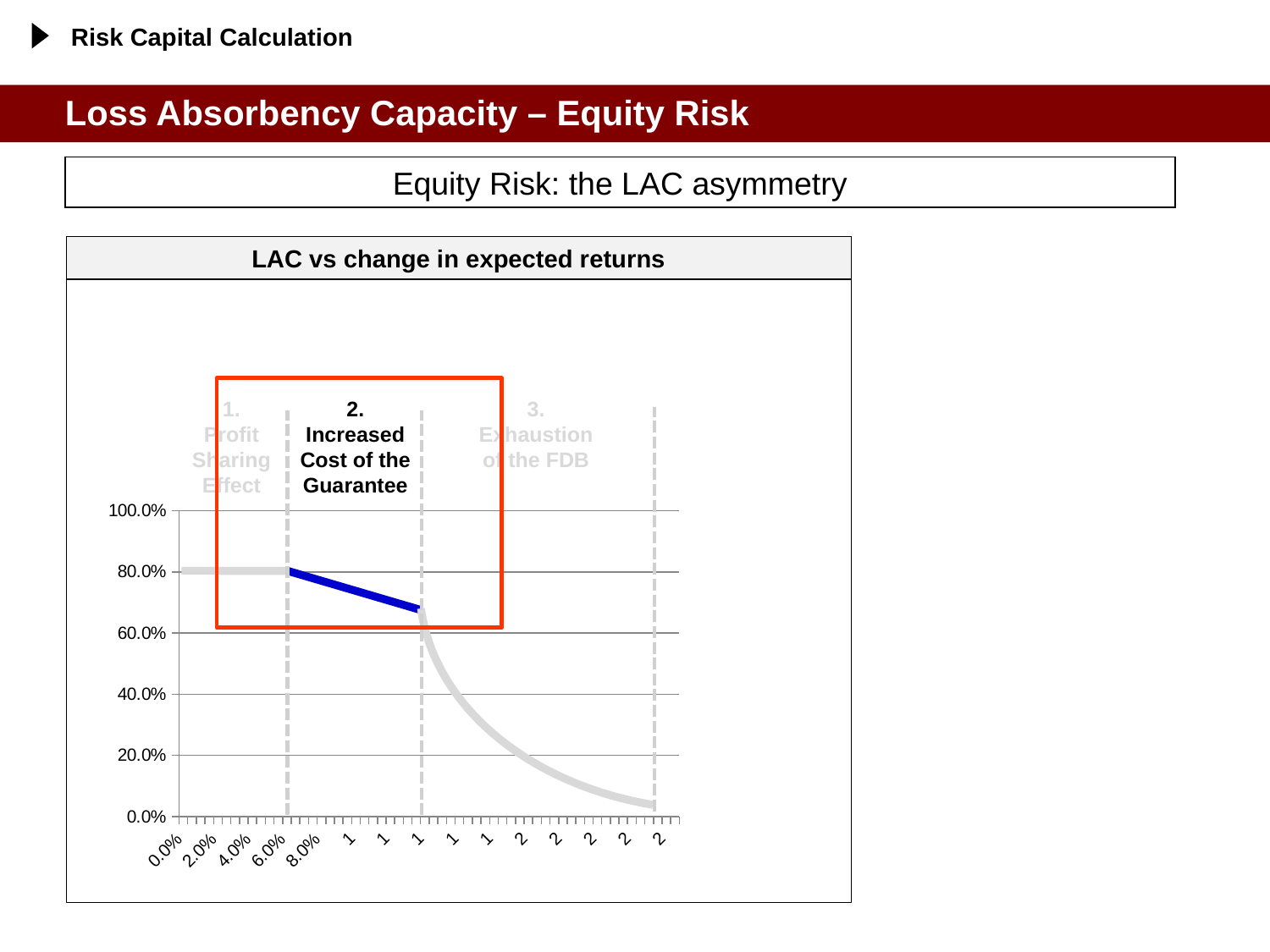
What is the highest tick value shown on the vertical axis? 100.0% Is the value of the line at 0.0% on the x axis greater or less than 60.0%? greater What is the title of the chart? LAC vs change in expected returns Is the value of the line at 2.0% on the x axis greater or less than 40.0%? greater Is the value at the right-hand end of the line greater or less than 20.0%? less What kind of chart is shown on the slide? line chart Which phase label is enclosed by the red box on the chart? 2. Increased Cost of the Guarantee Does the line rise or fall as you move from left to right along the x axis? fall